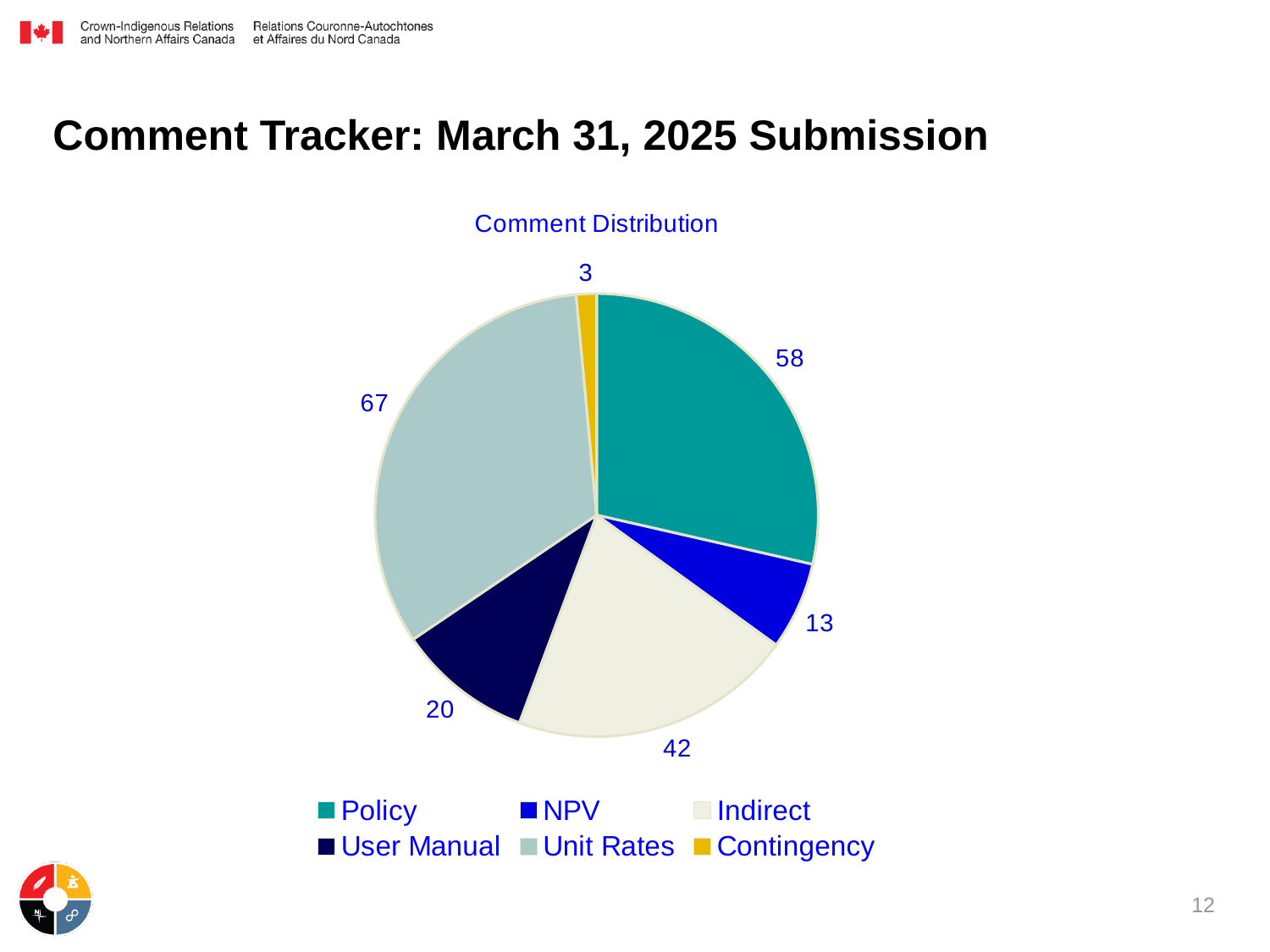
What is the value for NPV? 13 Which is larger, Indirect or User Manual? Indirect What type of chart is shown on the slide? Pie chart Which category has the largest slice? Unit Rates What is the title of the chart? Comment Distribution What is the total of all the slices in the pie chart? 203 What is the value for Unit Rates? 67 What is the value for Contingency? 3 What is the difference between the values for Unit Rates and Policy? 9 What is the value for Policy? 58 Which category has the smallest slice? Contingency How many categories does the pie chart have? 6